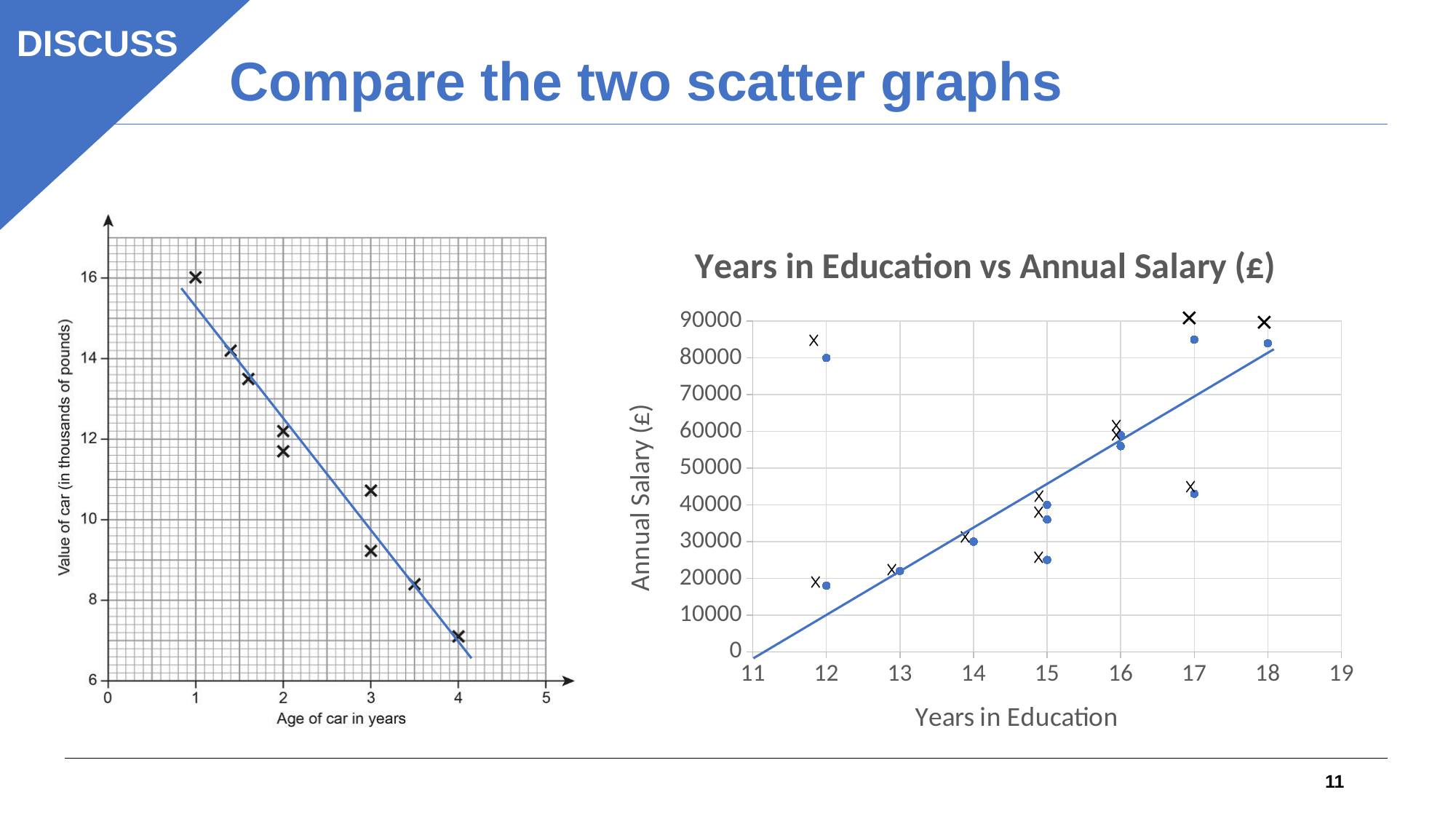
In the right-hand chart, is the annual salary for 18 years in education greater or less than 80000? greater In the left-hand chart (Age of car in years), do the values rise or fall as the age of the car increases? fall What is the title of the right-hand chart? Years in Education vs Annual Salary (£) In the left-hand chart, at which age of car is the value of the car lowest? 4 In the right-hand chart (Years in Education vs Annual Salary), does the trend line rise or fall as years in education increase? rise In the left-hand chart, is the value of the car at age 4 years greater or less than 8 (thousand pounds)? less What is the label on the vertical axis of the left-hand chart? Value of car (in thousands of pounds) In the left-hand chart, at which age of car is the value of the car highest? 1 In the right-hand chart, is the annual salary for 13 years in education greater or less than 30000? less In the right-hand chart, which has the higher annual salary: 18 years in education or 13 years in education? 18 years How many data points are plotted on the left-hand chart (Age of car in years)? 9 What kind of chart is the left-hand chart on the slide? scatter graph